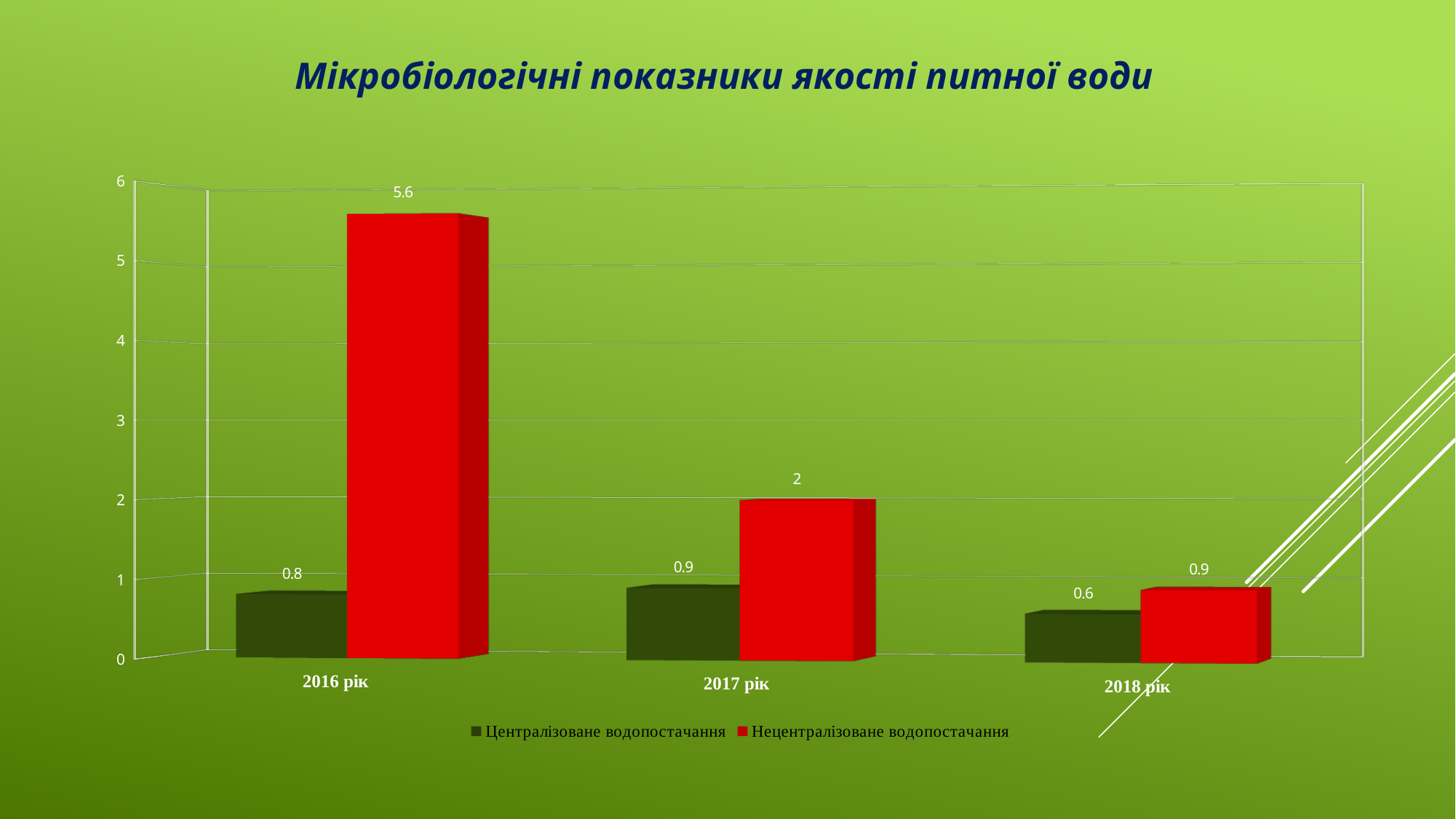
What is the value for Нецентралізоване водопостачання in 2017 рік? 2 What is the difference between Нецентралізоване водопостачання and Централізоване водопостачання in 2016 рік? 4.8 What is the value for Централізоване водопостачання in 2018 рік? 0.6 What kind of chart is shown on the slide? bar chart Do the values for Нецентралізоване водопостачання rise or fall from 2016 рік to 2018 рік? fall What is the value for Нецентралізоване водопостачання in 2016 рік? 5.6 Is the value for Нецентралізоване водопостачання in 2016 рік greater or less than 5? greater Which year has the highest value for Нецентралізоване водопостачання? 2016 рік Which is larger in 2018 рік: Централізоване водопостачання or Нецентралізоване водопостачання? Нецентралізоване водопостачання How many years are shown on the x axis? 3 Which year has the lowest value for Централізоване водопостачання? 2018 рік How many series does the legend list? 2